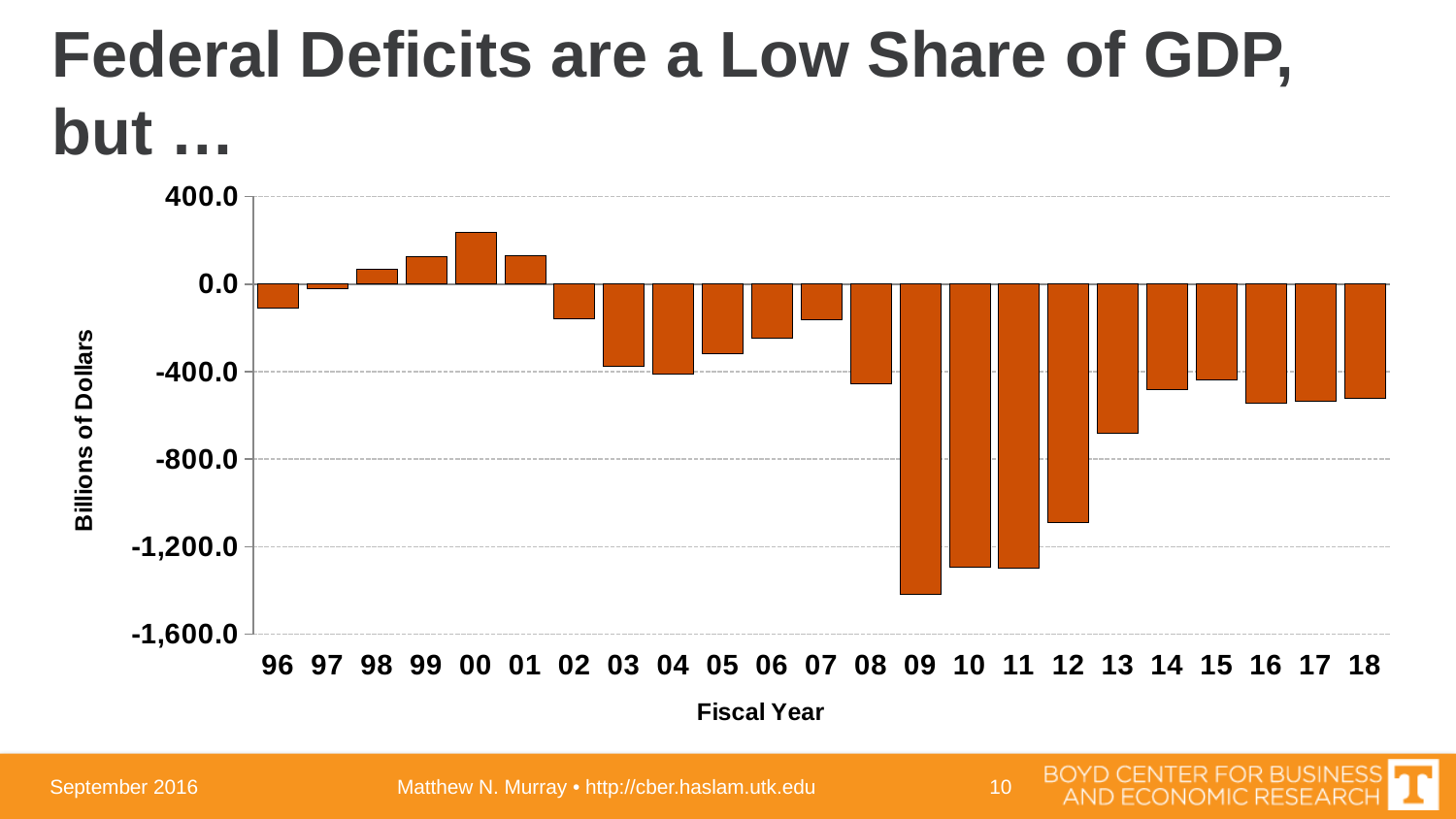
Do the values rise or fall from fiscal year 09 to fiscal year 13? rise Is the value for fiscal year 13 greater or less than -800.0? greater What is the title of the y axis? Billions of Dollars Is the value for fiscal year 08 greater or less than -400.0? less Is the value for fiscal year 00 greater or less than 0.0? greater Which fiscal year has the larger value, 00 or 01? 00 What kind of chart is shown on the slide? bar chart Which fiscal year has the highest value? 00 Which fiscal year has the lowest (most negative) value? 09 How many fiscal years are plotted on the x axis? 23